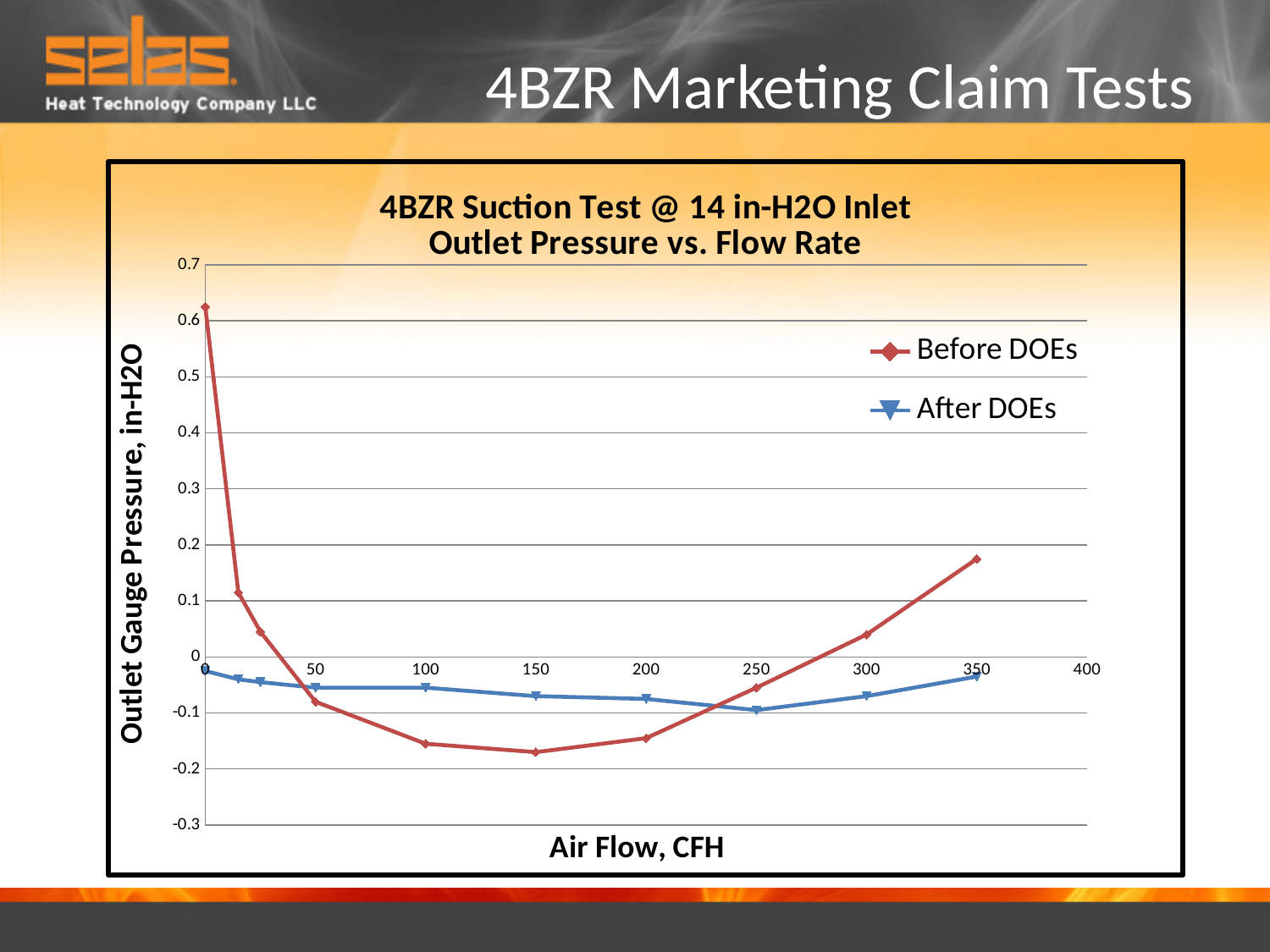
What are the two series named in the chart legend? Before DOEs and After DOEs What kind of chart is shown on the slide? line chart What is the label of the chart's x axis? Air Flow, CFH At an air flow of 350 CFH, which series has the higher outlet gauge pressure, Before DOEs or After DOEs? Before DOEs Is the Before DOEs value at an air flow of 350 CFH greater or less than 0.1? greater Is the Before DOEs value at an air flow of 0 CFH greater or less than 0.5? greater Is the After DOEs value at an air flow of 250 CFH greater or less than 0? less How many series does the chart legend list? 2 At which air flow value does the Before DOEs series reach its highest outlet gauge pressure? 0 Does the Before DOEs series rise or fall as air flow increases from 150 CFH to 350 CFH? rise At an air flow of 100 CFH, which series has the higher outlet gauge pressure, Before DOEs or After DOEs? After DOEs